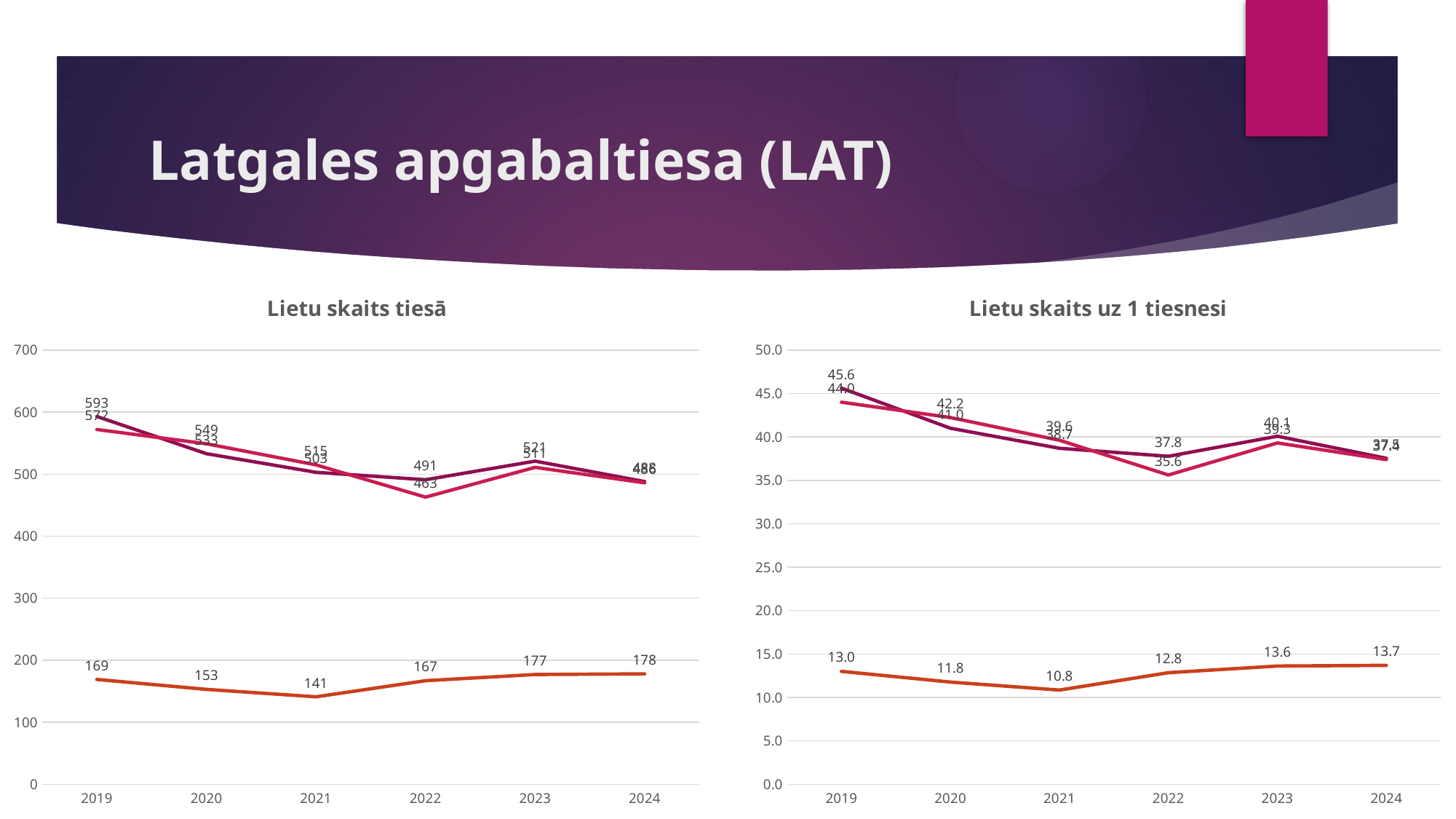
In the "Lietu skaits uz 1 tiesnesi" chart, what is the value of the orange line in 2021? 10.8 In the "Lietu skaits uz 1 tiesnesi" chart, in which year does the orange line reach its highest value? 2024 What type of chart is "Lietu skaits tiesā"? line chart In the "Lietu skaits uz 1 tiesnesi" chart, what is the value of the orange line in 2023? 13.6 In the "Lietu skaits uz 1 tiesnesi" chart, does the orange line rise or fall from 2021 to 2024? rise In the "Lietu skaits tiesā" chart, what is the value of the orange line in 2021? 141 How many years are shown on the x axis of the "Lietu skaits tiesā" chart? 6 In the "Lietu skaits tiesā" chart, in which year is the orange line at its lowest? 2021 In the "Lietu skaits tiesā" chart, is the orange line's value in 2019 greater or less than 200? less In the "Lietu skaits tiesā" chart, what is the difference between the orange line's values in 2024 and 2021? 37 In the "Lietu skaits uz 1 tiesnesi" chart, is the orange line's value in 2022 larger than its value in 2020? yes In the "Lietu skaits tiesā" chart, what is the value of the orange line in 2024? 178